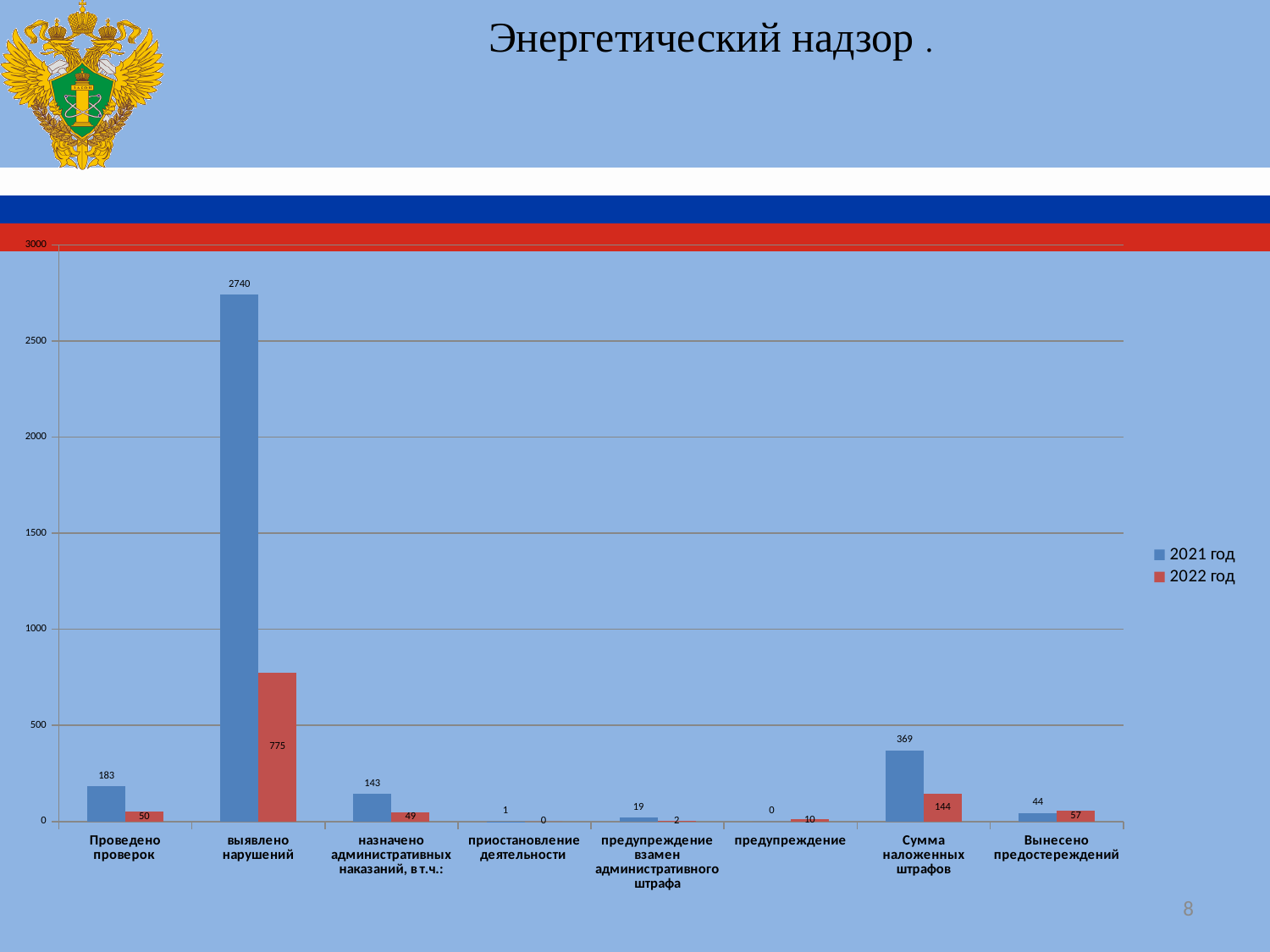
What is the value for 2021 год in the category 'предупреждение взамен административного штрафа'? 19 In the category 'Вынесено предостережений', which series has the larger value, 2021 год or 2022 год? 2022 год Which category has the lowest value for 2021 год? предупреждение How many categories are shown on the x axis? 8 What is the difference between the 2021 год and 2022 год values for 'Проведено проверок'? 133 What is the value for 2022 год in the category 'Сумма наложенных штрафов'? 144 What kind of chart is shown on the slide? bar chart How many series does the legend list? 2 What is the value for 2022 год in the category 'Проведено проверок'? 50 What is the difference between the 2021 год and 2022 год values for 'выявлено нарушений'? 1965 What is the value for 2021 год in the category 'выявлено нарушений'? 2740 Which category has the highest value for 2021 год? выявлено нарушений